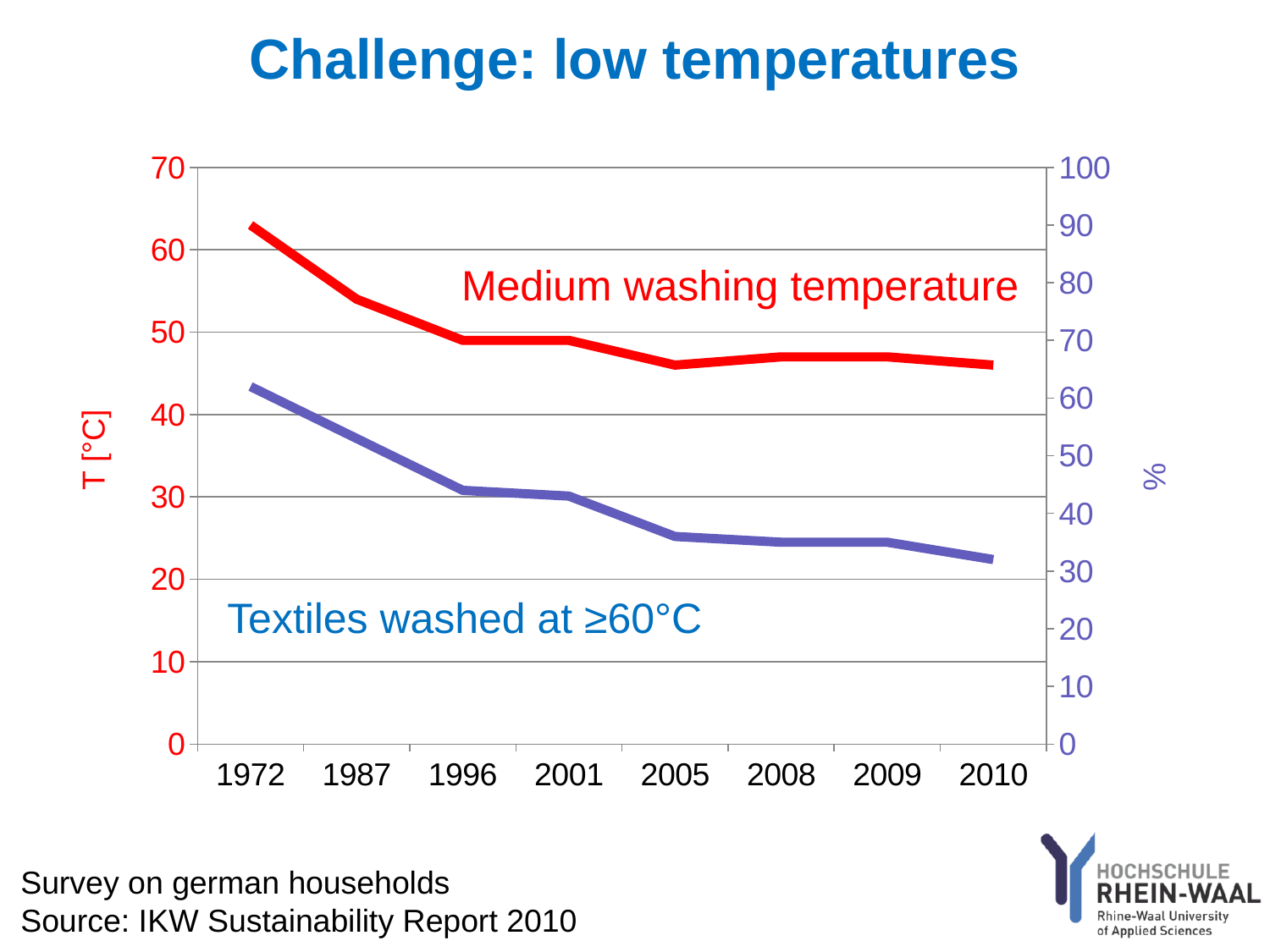
Does the Medium washing temperature line rise or fall from 1972 to 2010? fall What is the label of the left vertical axis? T [°C] In which year is the Medium washing temperature highest? 1972 How many data series (lines) are plotted on the chart? 2 Does the Textiles washed at ≥60°C line rise or fall from 1972 to 2010? fall Is the Medium washing temperature in 1972 greater or less than 60? greater Is the share of Textiles washed at ≥60°C in 1972 greater or less than 50? greater Is the share of Textiles washed at ≥60°C in 2010 greater or less than 40? less How many years are shown on the x axis of the chart? 8 In which year is the share of Textiles washed at ≥60°C lowest? 2010 What kind of chart is shown on the slide? line chart